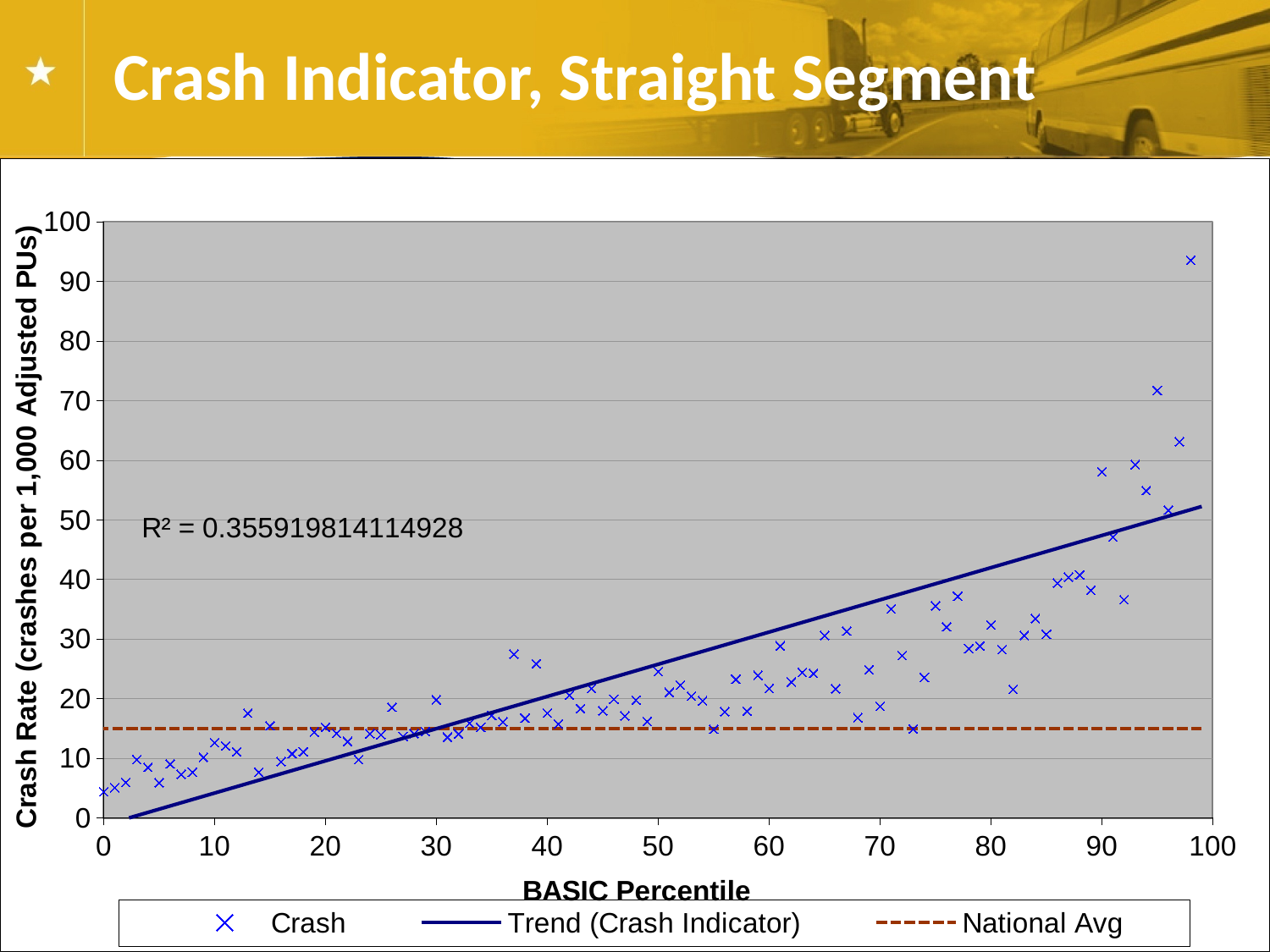
What is the title of the chart? Crash Indicator, Straight Segment Is the highest Crash point on the chart greater or less than 90? greater Is the Crash value at a BASIC Percentile of 0 greater or less than 10? less What is the R² value printed on the chart? 0.355919814114928 How many series does the legend list? 3 Do the Crash values generally rise or fall as the BASIC Percentile increases? rise What is the label of the x axis? BASIC Percentile Does the Trend (Crash Indicator) line rise or fall from left to right? rise Is the National Avg line greater or less than 20 crashes per 1,000 Adjusted PUs? less What kind of chart is shown on the slide? scatter chart